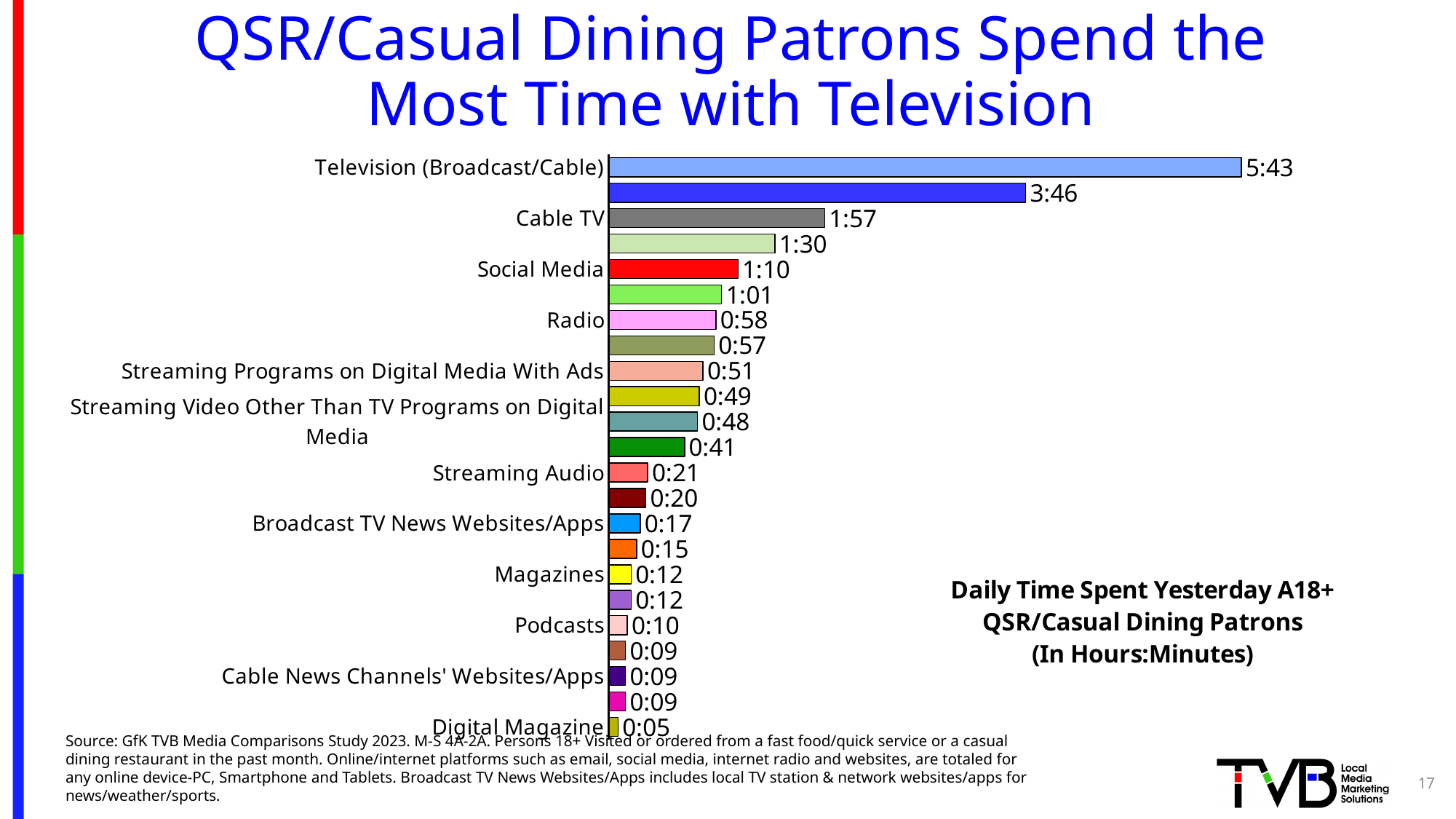
Which category has the lowest daily time spent? Digital Magazine What is the daily time spent with Cable TV? 1:57 What is the daily time spent with Television (Broadcast/Cable)? 5:43 What is the daily time spent with Podcasts? 0:10 How much more time is spent with Television (Broadcast/Cable) than with Cable TV? 3:46 How many bars are plotted in the chart? 23 What kind of chart is shown on the slide? Bar chart What is the daily time spent with Social Media? 1:10 What is the daily time spent with Streaming Programs on Digital Media With Ads? 0:51 What is the daily time spent with Radio? 0:58 Which has a higher daily time spent, Streaming Audio or Broadcast TV News Websites/Apps? Streaming Audio Which category has the highest daily time spent? Television (Broadcast/Cable)